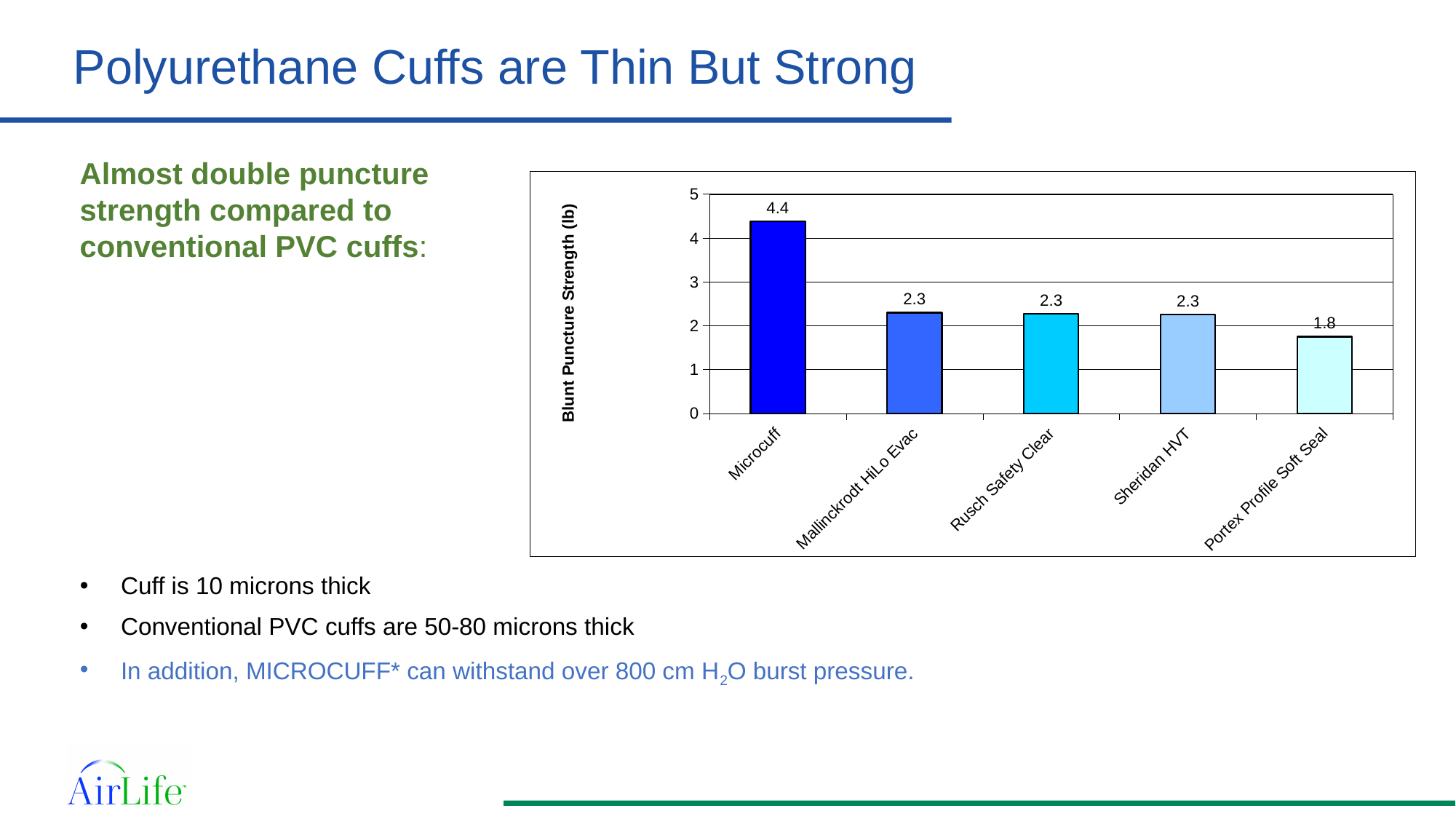
What kind of chart is shown on the slide? bar chart What is the blunt puncture strength for Portex Profile Soft Seal? 1.8 What is the blunt puncture strength for Microcuff? 4.4 Which has a larger blunt puncture strength, Microcuff or Sheridan HVT? Microcuff How many products are shown on the chart? 5 What is the blunt puncture strength for Sheridan HVT? 2.3 Which product has the lowest blunt puncture strength? Portex Profile Soft Seal What is the label of the vertical axis of the chart? Blunt Puncture Strength (lb) What is the difference in blunt puncture strength between Microcuff and Mallinckrodt HiLo Evac? 2.1 Which product has the highest blunt puncture strength? Microcuff Is the blunt puncture strength for Microcuff greater or less than 4? greater What is the difference in blunt puncture strength between Rusch Safety Clear and Portex Profile Soft Seal? 0.5